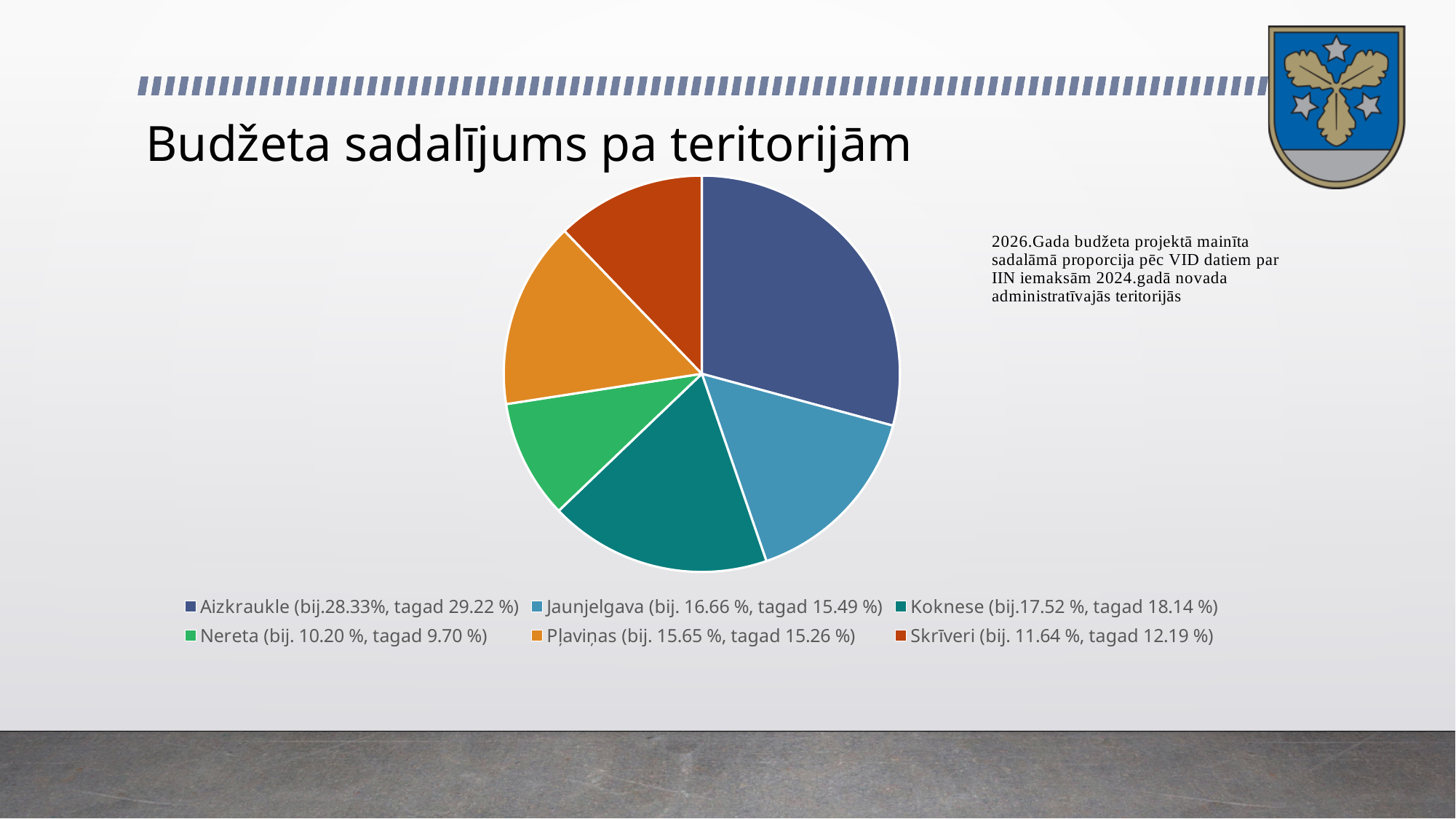
According to the legend, what was the previous ('bij.') share for Nereta? 10.20 % Which territory has the smallest slice of the pie chart? Nereta According to the legend, what is the current ('tagad') share for Aizkraukle? 29.22 % How many slices does the pie chart have? 6 According to the legend, what is the current ('tagad') share for Skrīveri? 12.19 % What colour is the Pļaviņas slice in the pie chart? orange By how many percentage points does the current share for Aizkraukle exceed the current share for Koknese, using the legend values? 11.08 What kind of chart is shown on the slide? pie chart According to the legend, what is the current ('tagad') share for Koknese? 18.14 % Which slice is larger, Koknese or Jaunjelgava? Koknese What is the title of the chart on the slide? Budžeta sadalījums pa teritorijām Which territory has the largest slice of the pie chart? Aizkraukle